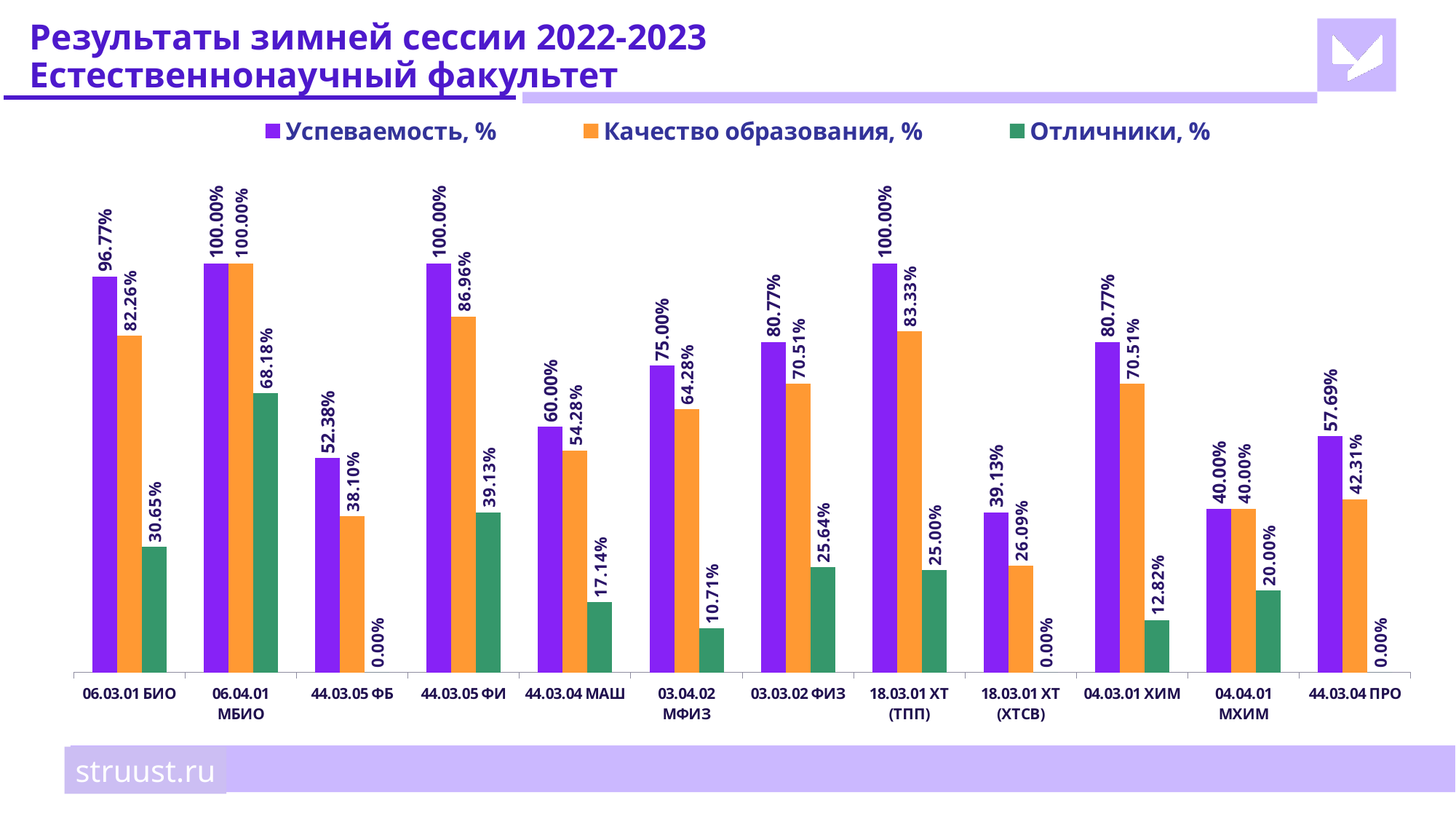
Which category has the highest value of Отличники, %? 06.04.01 МБИО What is the value of Качество образования, % for 44.03.05 ФИ? 86.96% What is the value of Успеваемость, % for 06.03.01 БИО? 96.77% What is the value of Отличники, % for 03.04.02 МФИЗ? 10.71% How many categories have an Отличники, % value of 0.00%? 3 Which category has the lowest value of Успеваемость, %? 18.03.01 ХТ (ХТСВ) What is the title of the chart's slide? Результаты зимней сессии 2022-2023 Естественнонаучный факультет How many categories (programmes) are shown on the x axis? 12 Which is larger: Отличники, % for 44.03.04 МАШ or for 04.04.01 МХИМ? 04.04.01 МХИМ How many series does the legend list? 3 What is the difference between Успеваемость, % and Качество образования, % for 06.03.01 БИО? 14.51% What type of chart is shown on the slide? bar chart